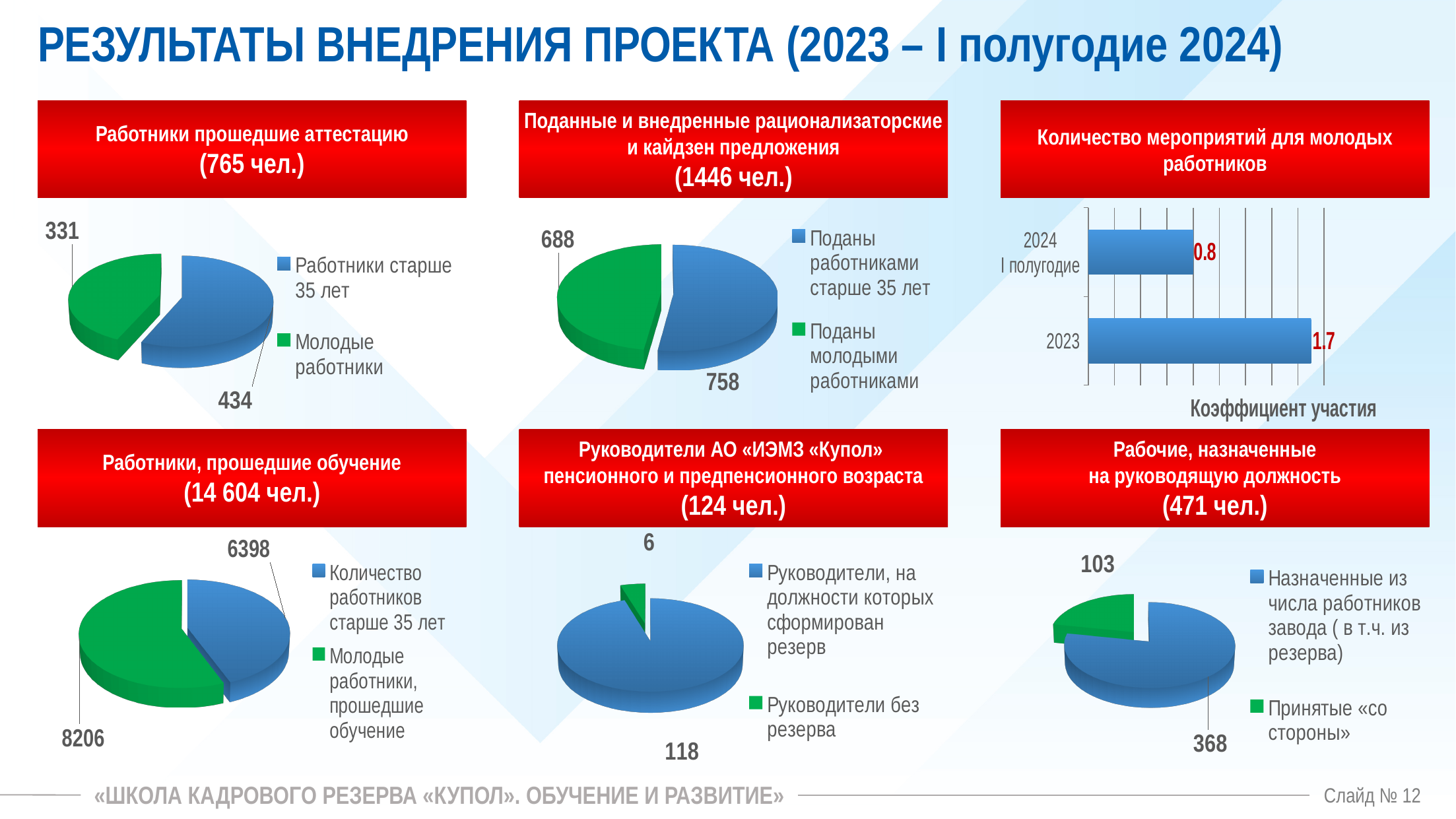
In the chart 'Руководители АО «ИЭМЗ «Купол» пенсионного и предпенсионного возраста', what is the value for 'Руководители без резерва'? 6 In the chart 'Рабочие, назначенные на руководящую должность', what is the value for 'Принятые «со стороны»'? 103 In the chart 'Работники прошедшие аттестацию', what is the difference between 'Работники старше 35 лет' and 'Молодые работники'? 103 In the chart 'Поданные и внедренные рационализаторские и кайдзен предложения', which is larger: 'Поданы работниками старше 35 лет' or 'Поданы молодыми работниками'? Поданы работниками старше 35 лет In the chart 'Количество мероприятий для молодых работников', what is the value for 2023? 1.7 In the chart 'Работники, прошедшие обучение', what is the difference between 'Молодые работники, прошедшие обучение' and 'Количество работников старше 35 лет'? 1808 In the chart 'Работники, прошедшие обучение', which category is the largest? Молодые работники, прошедшие обучение How many series does the legend of the chart 'Рабочие, назначенные на руководящую должность' list? 2 In the chart 'Работники прошедшие аттестацию', what is the value for 'Молодые работники'? 331 What kind of chart is 'Количество мероприятий для молодых работников'? bar chart In the chart 'Поданные и внедренные рационализаторские и кайдзен предложения', what is the value for 'Поданы молодыми работниками'? 688 In the chart 'Количество мероприятий для молодых работников', what is the value for '2024 I полугодие'? 0.8